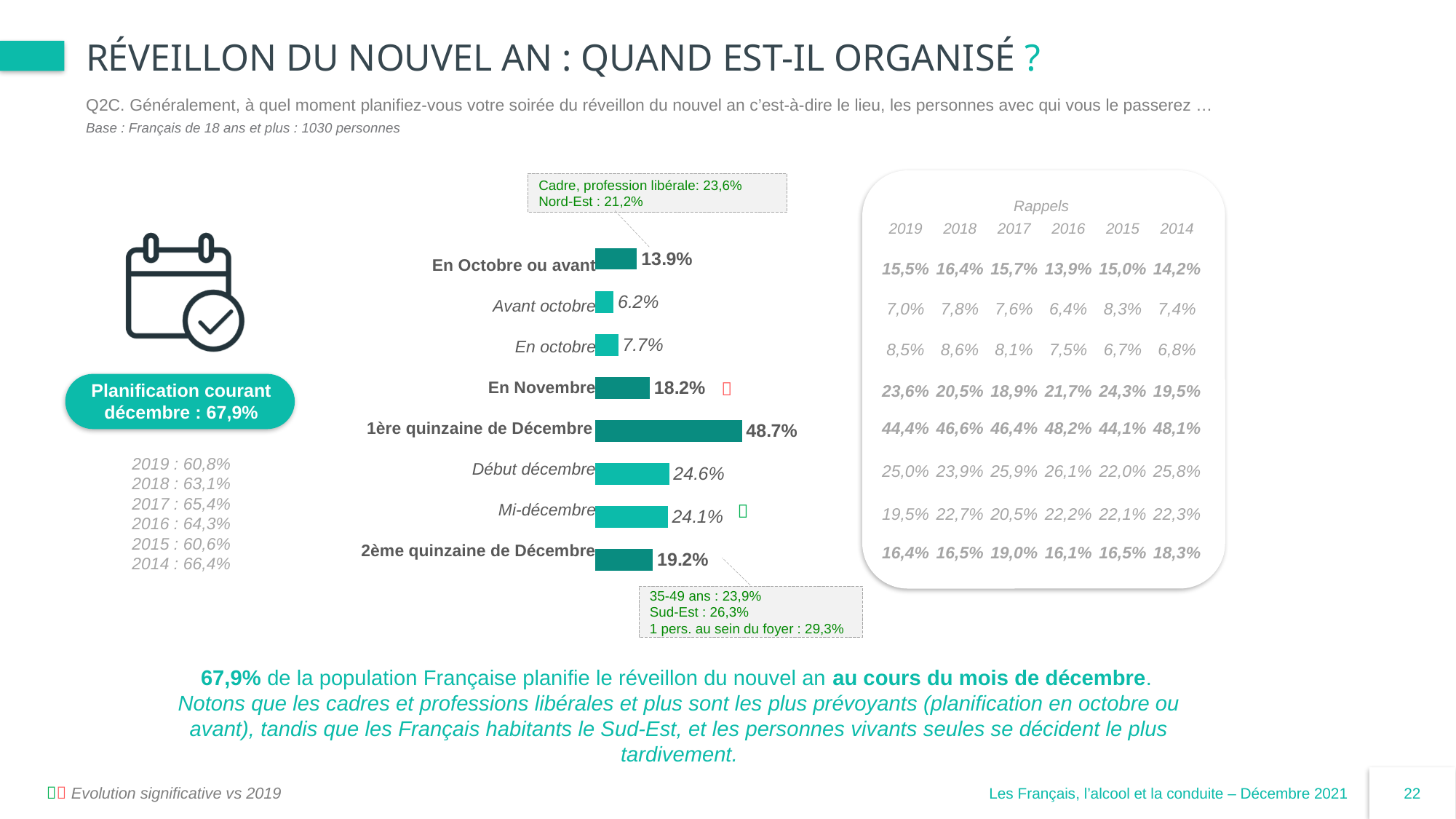
What is the difference between "En Novembre" and "En Octobre ou avant"? 4.3% What is the total of "Avant octobre" and "En octobre"? 13.9% What is the value for "Avant octobre"? 6.2% Which category has the highest value? 1ère quinzaine de Décembre How many categories are shown in the bar chart? 8 Which category has the lowest value? Avant octobre Which is larger, "En octobre" or "Avant octobre"? En octobre What is the value for "1ère quinzaine de Décembre"? 48.7% What kind of chart is shown on the slide? Bar chart What is the value for "2ème quinzaine de Décembre"? 19.2% What is the value for "En Novembre"? 18.2% What is the difference between "Début décembre" and "Mi-décembre"? 0.5%